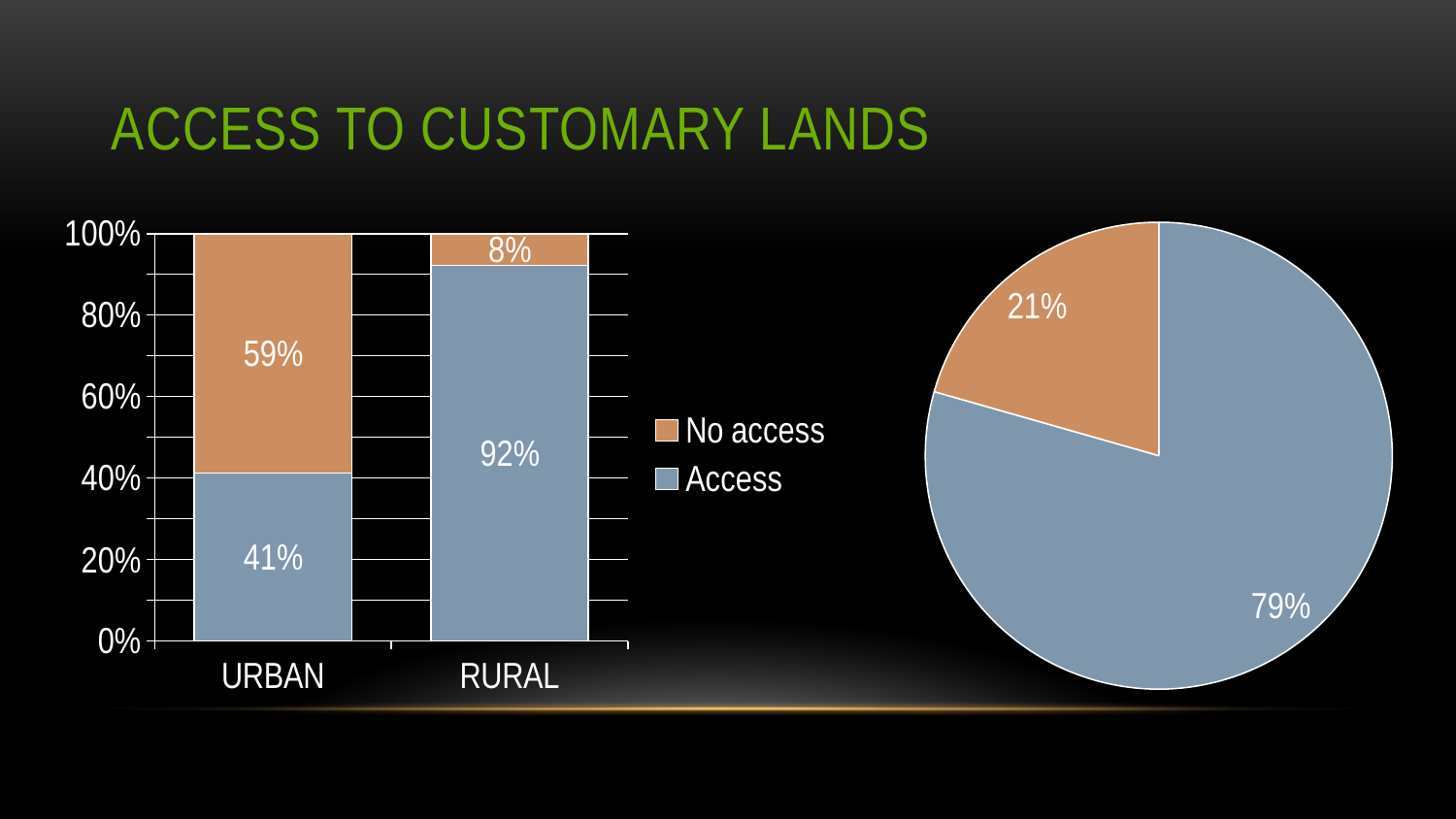
In the bar chart on the left, what is the No access value for RURAL? 8% In the bar chart on the left, what is the difference between the Access values for RURAL and URBAN? 51% In the bar chart on the left, how many categories are shown on the x axis? 2 What kind of chart is on the left of the slide? Stacked bar chart What is the title of the slide? ACCESS TO CUSTOMARY LANDS In the pie chart on the right, what share is shown for the orange (No access) slice? 21% In the pie chart on the right, what share is shown for the blue (Access) slice? 79% In the bar chart on the left, which category has the higher Access value, URBAN or RURAL? RURAL How many series does the legend list? 2 In the bar chart on the left, what is the Access value for URBAN? 41% In the bar chart on the left, what is the Access value for RURAL? 92% In the bar chart on the left, what is the No access value for URBAN? 59%